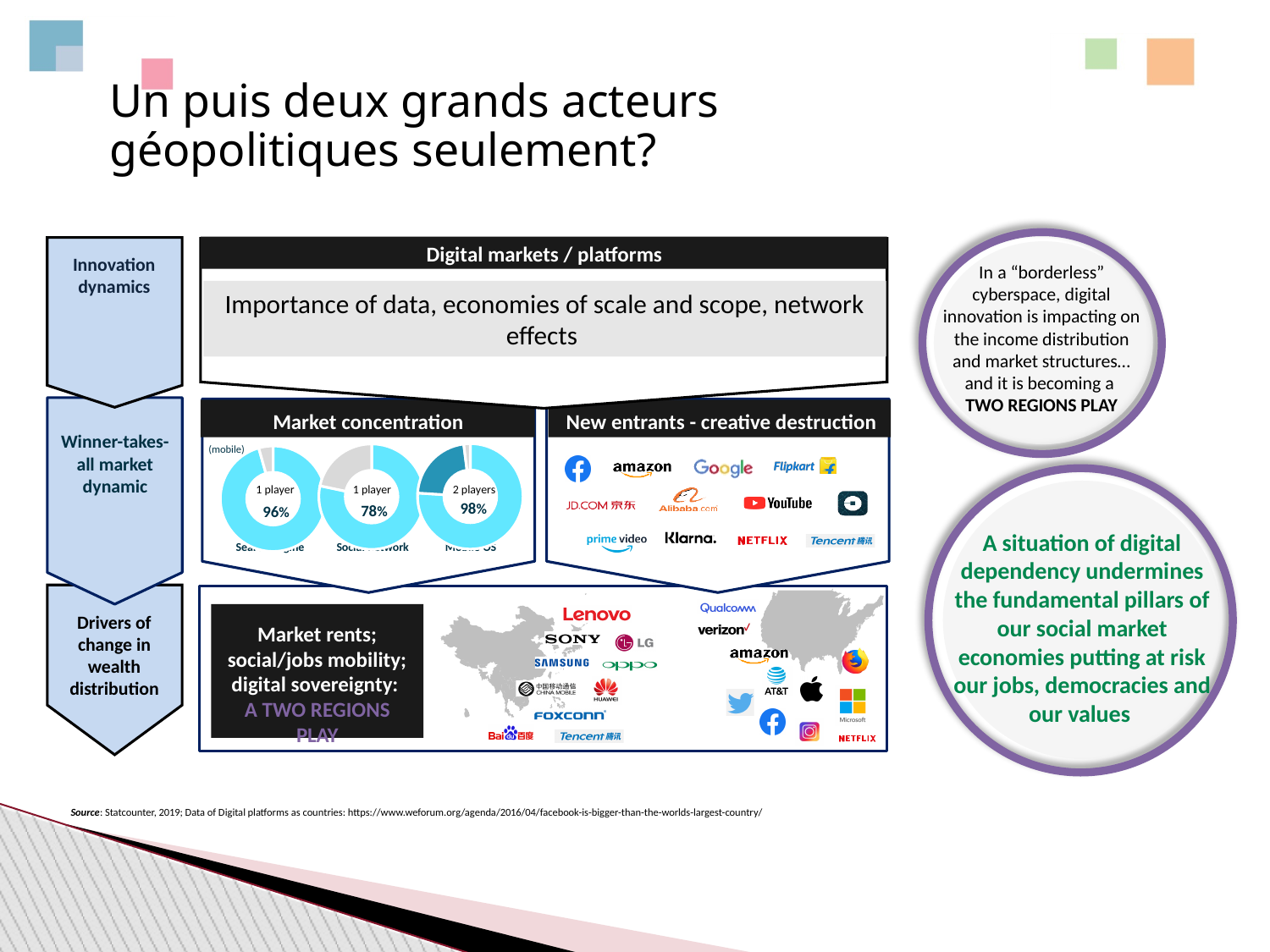
What kind of charts are used in the Market concentration section? Donut (pie) charts What is the title of the panel containing the three donut charts? Market concentration In the Market concentration section, how many players does the right donut chart's label refer to? 2 players In the Market concentration section, what share is shown for the right donut chart labelled 2 players? 98% In the Market concentration section, is the share in the left donut chart larger or smaller than the share in the middle donut chart? Larger In the Market concentration section, what share is shown for the middle donut chart labelled 1 player? 78% In the Market concentration section, what is the difference between the share in the right donut (98%) and the left donut (96%)? 2% How many donut charts are shown in the Market concentration section? 3 In the Market concentration section, which of the three donut charts shows the lowest share? The middle donut (1 player, 78%) In the Market concentration section, what is the difference between the share in the left donut (96%) and the middle donut (78%)? 18% In the Market concentration section, what share is shown for the left donut chart labelled 1 player? 96% In the Market concentration section, which of the three donut charts shows the highest share? The right donut (2 players, 98%)